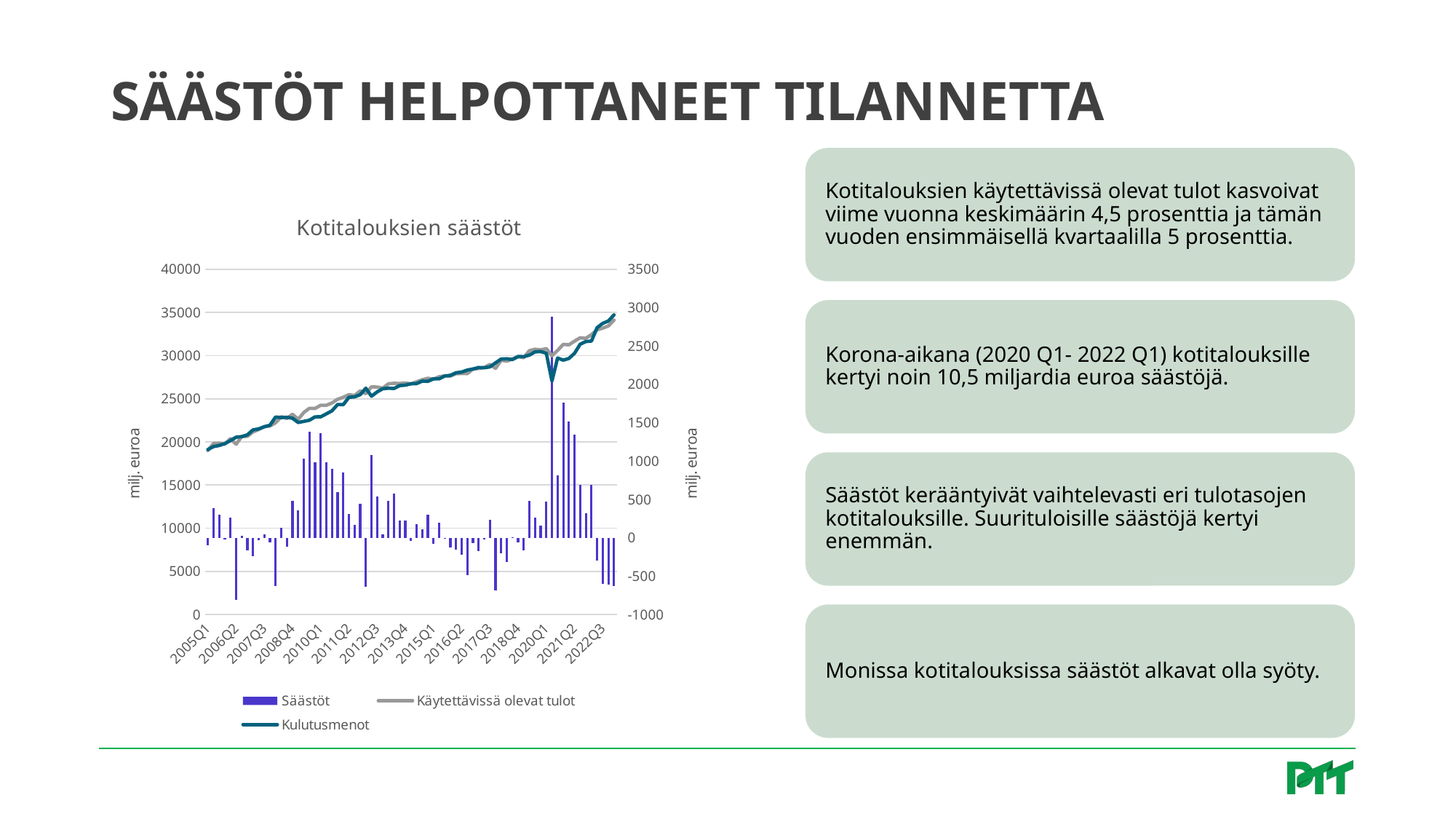
What is the title of the chart? Kotitalouksien säästöt What is the highest tick value shown on the left vertical axis of the chart? 40000 Does the Kulutusmenot line generally rise or fall across the x axis? rise Is the value of Kulutusmenot at 2005Q1 greater or less than 20000? less What kind of chart is shown on the slide? Combined bar and line chart How many series does the chart legend list? 3 How many category labels are shown on the x axis of the chart? 15 Which series is drawn as bars in the chart? Säästöt Is the value of Käytettävissä olevat tulot at 2022Q3 greater or less than 30000? greater Does the Käytettävissä olevat tulot line rise or fall from 2005Q1 to 2022Q3? rise Is the value of Käytettävissä olevat tulot at 2015Q1 greater or less than 25000? greater